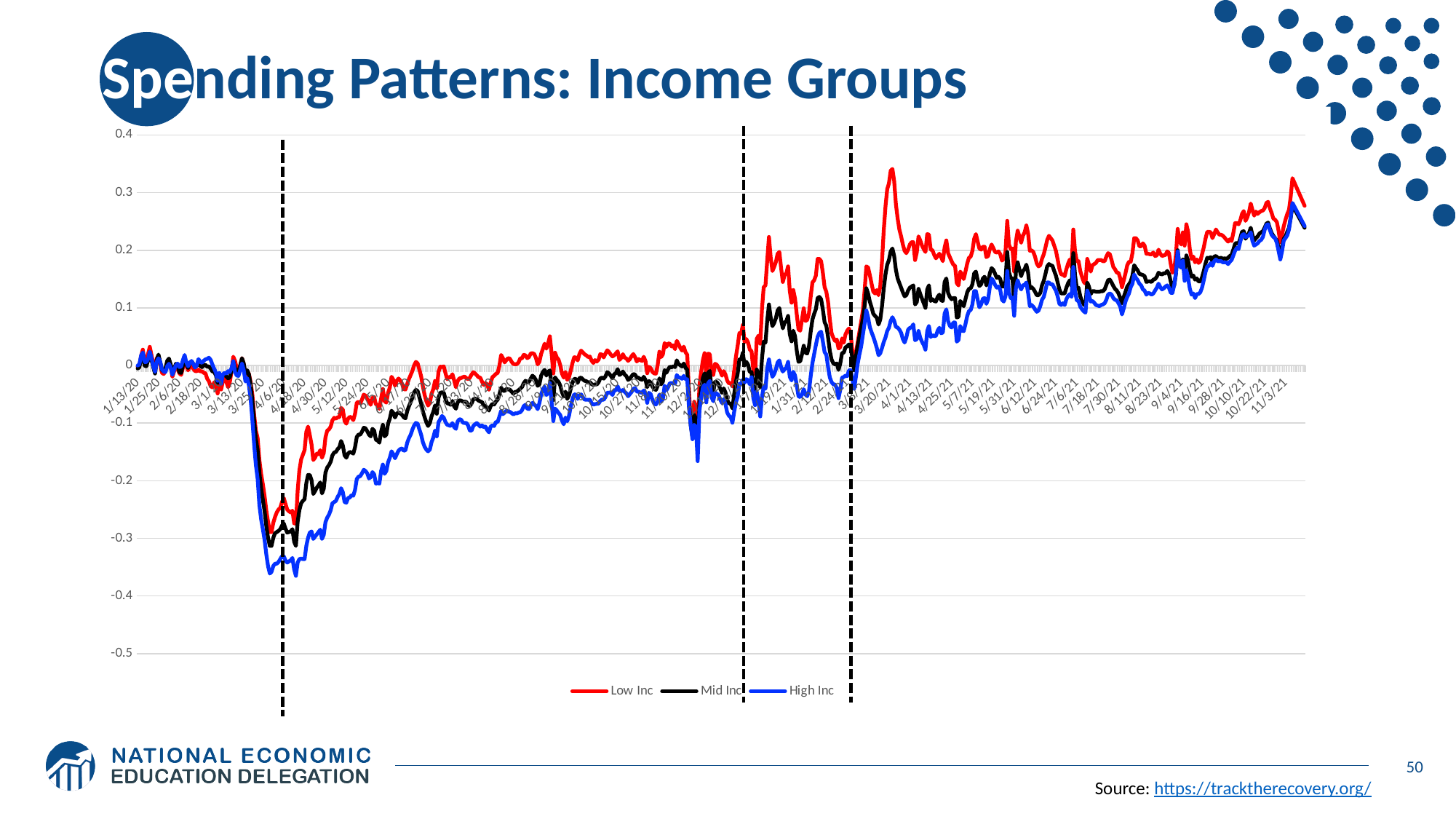
Is the value of the High Inc series around 4/1/21 greater or less than 0.1? less Which series has the highest peak around 4/1/21? Low Inc Which series is drawn in blue? High Inc Is the peak of the Low Inc series around 4/1/21 greater or less than 0.3? greater Do the series generally rise or fall from April 2020 to November 2021? rise Which series reaches the lowest value during the spring 2020 drop? High Inc Is the lowest value of the High Inc series in spring 2020 greater or less than -0.3? less How many series does the legend list? 3 Around 4/1/21, which series is higher: Low Inc or High Inc? Low Inc What kind of chart is shown on the slide? line chart What is the title of the slide's chart? Spending Patterns: Income Groups